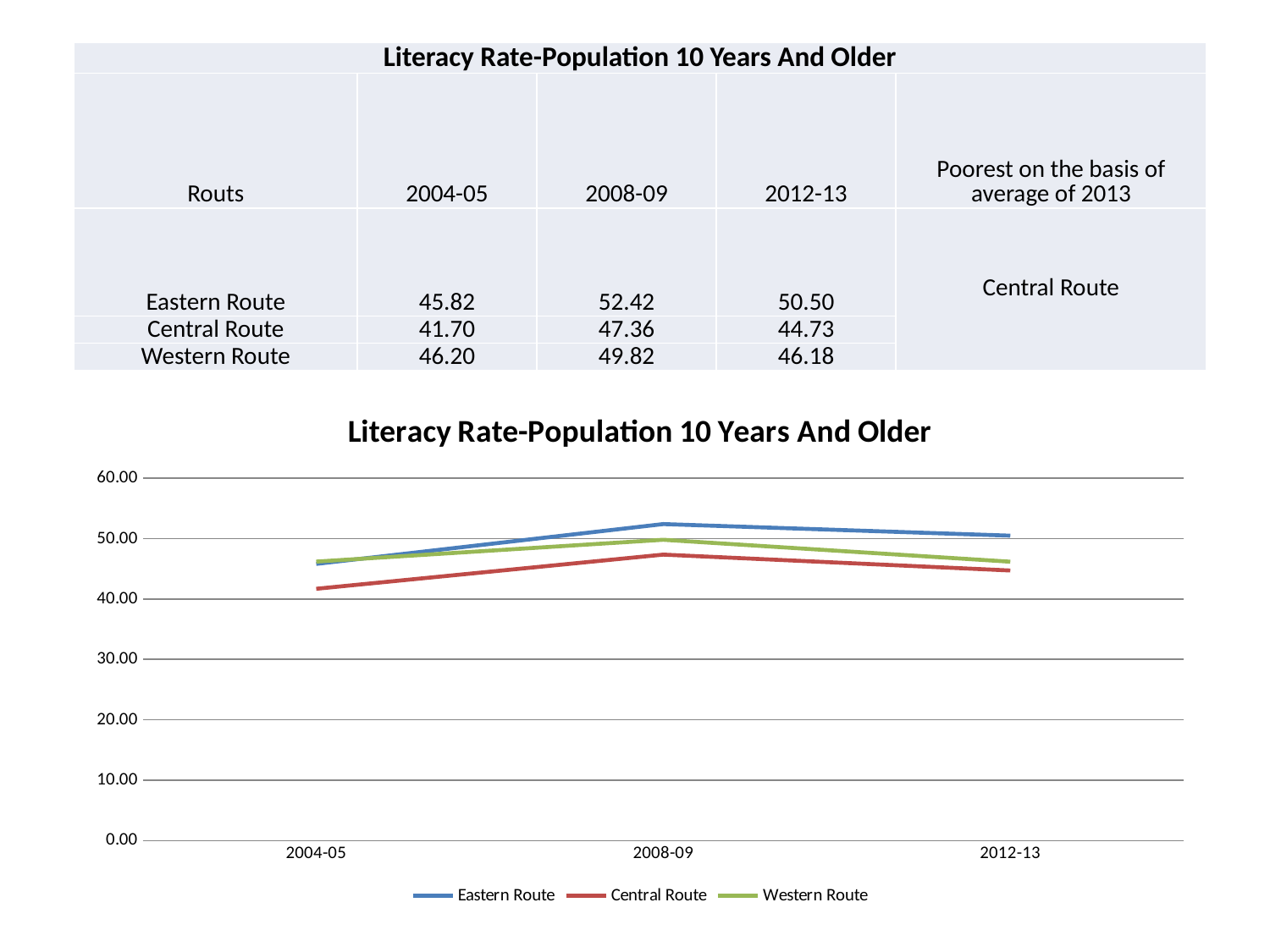
What is the value for Central Route in 2004-05? 41.70 Is the value for Central Route in 2004-05 greater or less than 40.00? greater What is the title of the chart? Literacy Rate-Population 10 Years And Older What is the difference between the Eastern Route and Central Route values in 2012-13? 5.77 Which route has the lowest value in 2012-13? Central Route Does the Central Route line rise or fall from 2008-09 to 2012-13? fall How many points are on the x axis of the chart? 3 What is the value for Western Route in 2012-13? 46.18 What kind of chart is shown on the slide? line chart Which route has the highest value in 2008-09? Eastern Route What is the value for Eastern Route in 2008-09? 52.42 How many series does the chart legend list? 3